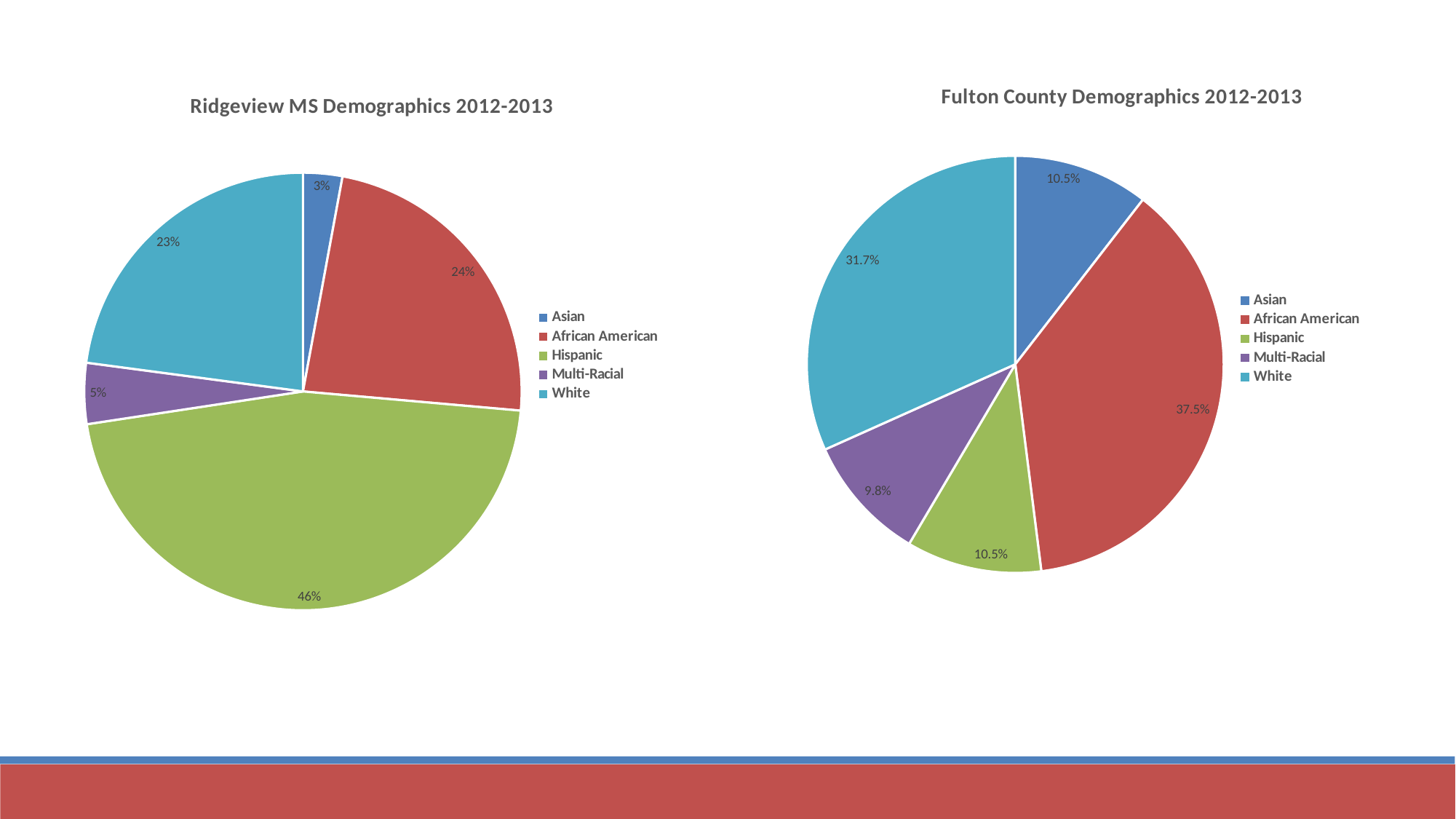
How many slices does the Ridgeview MS Demographics 2012-2013 chart have? 5 In the Ridgeview MS Demographics 2012-2013 chart, what percentage is Hispanic? 46% In the Ridgeview MS Demographics 2012-2013 chart, what is the difference between the African American and White percentages? 1% In the Fulton County Demographics 2012-2013 chart, what percentage is African American? 37.5% In the Fulton County Demographics 2012-2013 chart, which group has the smallest share? Multi-Racial In the Fulton County Demographics 2012-2013 chart, what percentage is White? 31.7% In the Ridgeview MS Demographics 2012-2013 chart, what percentage is Asian? 3% In the Ridgeview MS Demographics 2012-2013 chart, what colour represents White? Teal (light blue) In the Fulton County Demographics 2012-2013 chart, which is larger, the White share or the African American share? African American What kind of chart is the Fulton County Demographics 2012-2013 chart? Pie chart In the Fulton County Demographics 2012-2013 chart, what is the difference between the African American and Hispanic percentages? 27.0% In the Ridgeview MS Demographics 2012-2013 chart, which group has the largest share? Hispanic